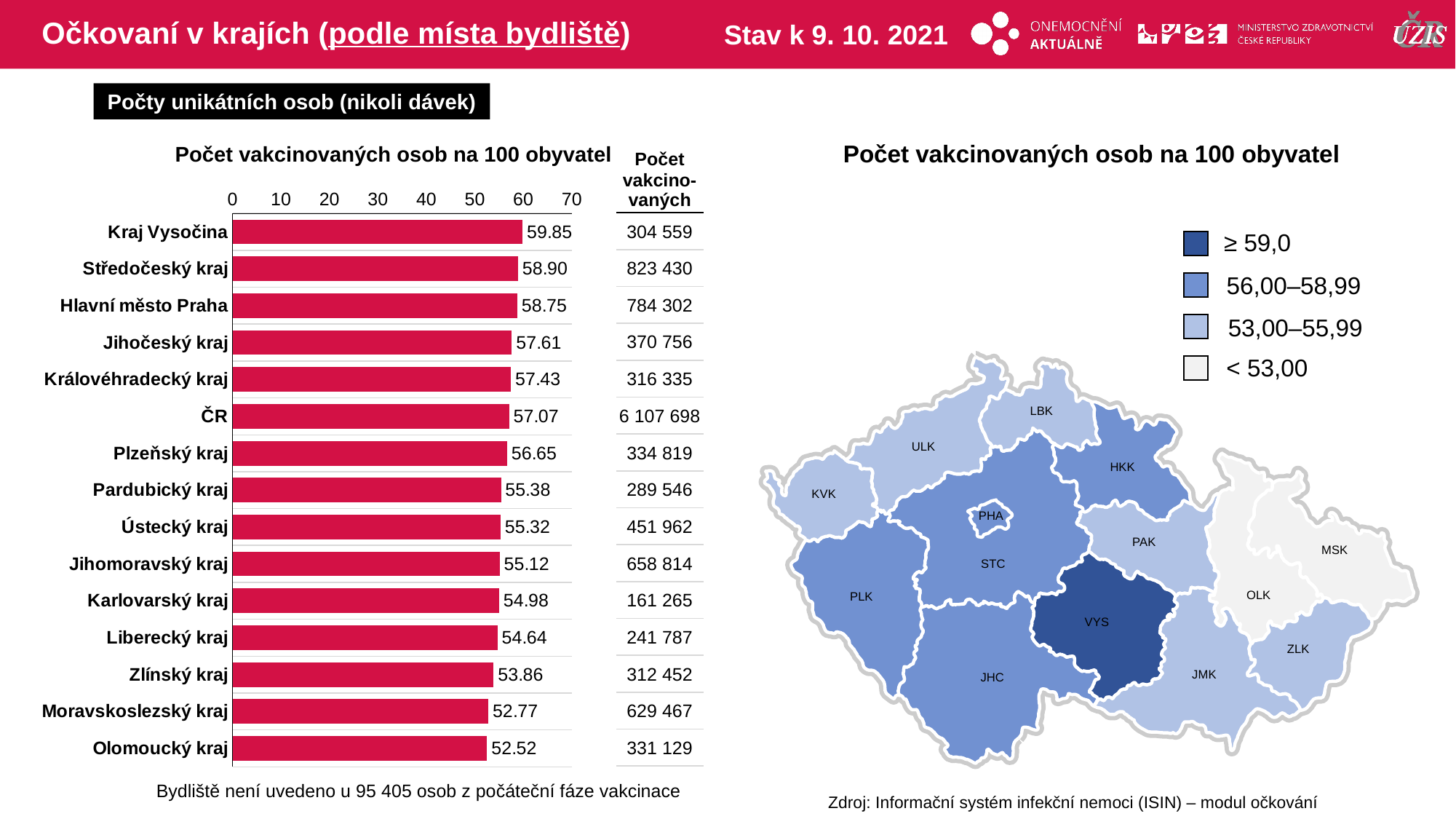
In the bar chart 'Počet vakcinovaných osob na 100 obyvatel', which region has the highest value? Kraj Vysočina In the bar chart 'Počet vakcinovaných osob na 100 obyvatel', what is the value for ČR? 57.07 In the bar chart 'Počet vakcinovaných osob na 100 obyvatel', what is the value for Kraj Vysočina? 59.85 In the bar chart 'Počet vakcinovaných osob na 100 obyvatel', which is larger, the value for Plzeňský kraj or the value for Liberecký kraj? Plzeňský kraj In the bar chart 'Počet vakcinovaných osob na 100 obyvatel', is the value for Moravskoslezský kraj greater or less than 60? less How many bars are shown in the bar chart 'Počet vakcinovaných osob na 100 obyvatel'? 15 In the table column 'Počet vakcinovaných' next to the bar chart, what is the value for Středočeský kraj? 823 430 In the bar chart 'Počet vakcinovaných osob na 100 obyvatel', which region has the lowest value? Olomoucký kraj In the bar chart 'Počet vakcinovaných osob na 100 obyvatel', what is the difference between the values for Kraj Vysočina and Olomoucký kraj? 7.33 What kind of chart is 'Počet vakcinovaných osob na 100 obyvatel' on the left of the slide? bar chart In the map legend on the right of the slide, what range does the darkest blue colour represent? ≥ 59,0 In the bar chart 'Počet vakcinovaných osob na 100 obyvatel', what is the value for Zlínský kraj? 53.86